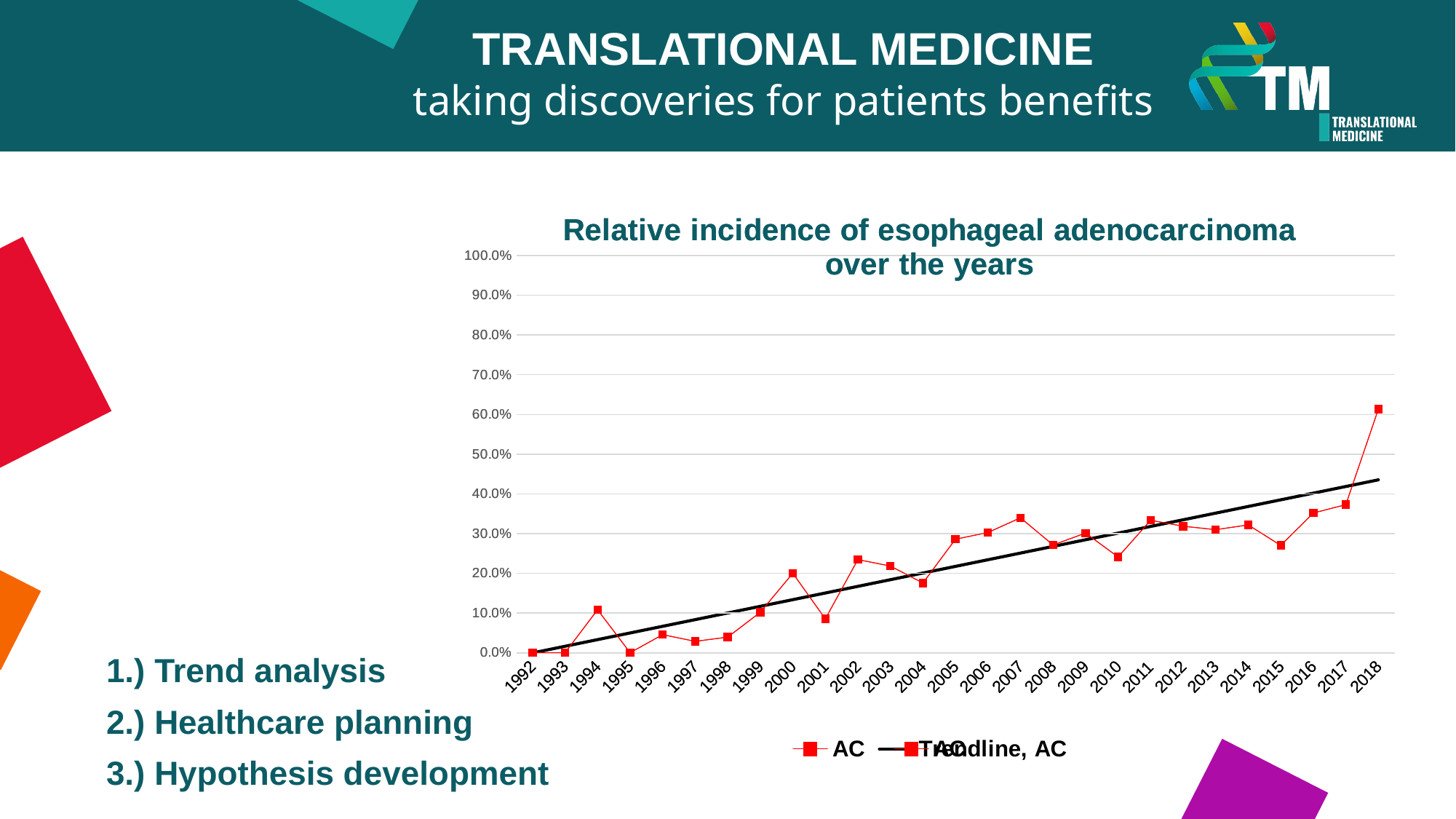
Is the AC value for 2018 greater or less than 50.0%? greater Which year has the highest AC value in the chart? 2018 Is the AC value for 2017 greater or less than 30.0%? greater What is the AC value for 1992? 0.0% What is the title of the chart? Relative incidence of esophageal adenocarcinoma over the years Which year has the larger AC value, 2000 or 2001? 2000 Is the AC value for 2001 greater or less than 20.0%? less Overall, do the AC values rise or fall from 1992 to 2018? rise What kind of chart is shown on the slide? line chart How many years are plotted along the x axis of the chart? 27